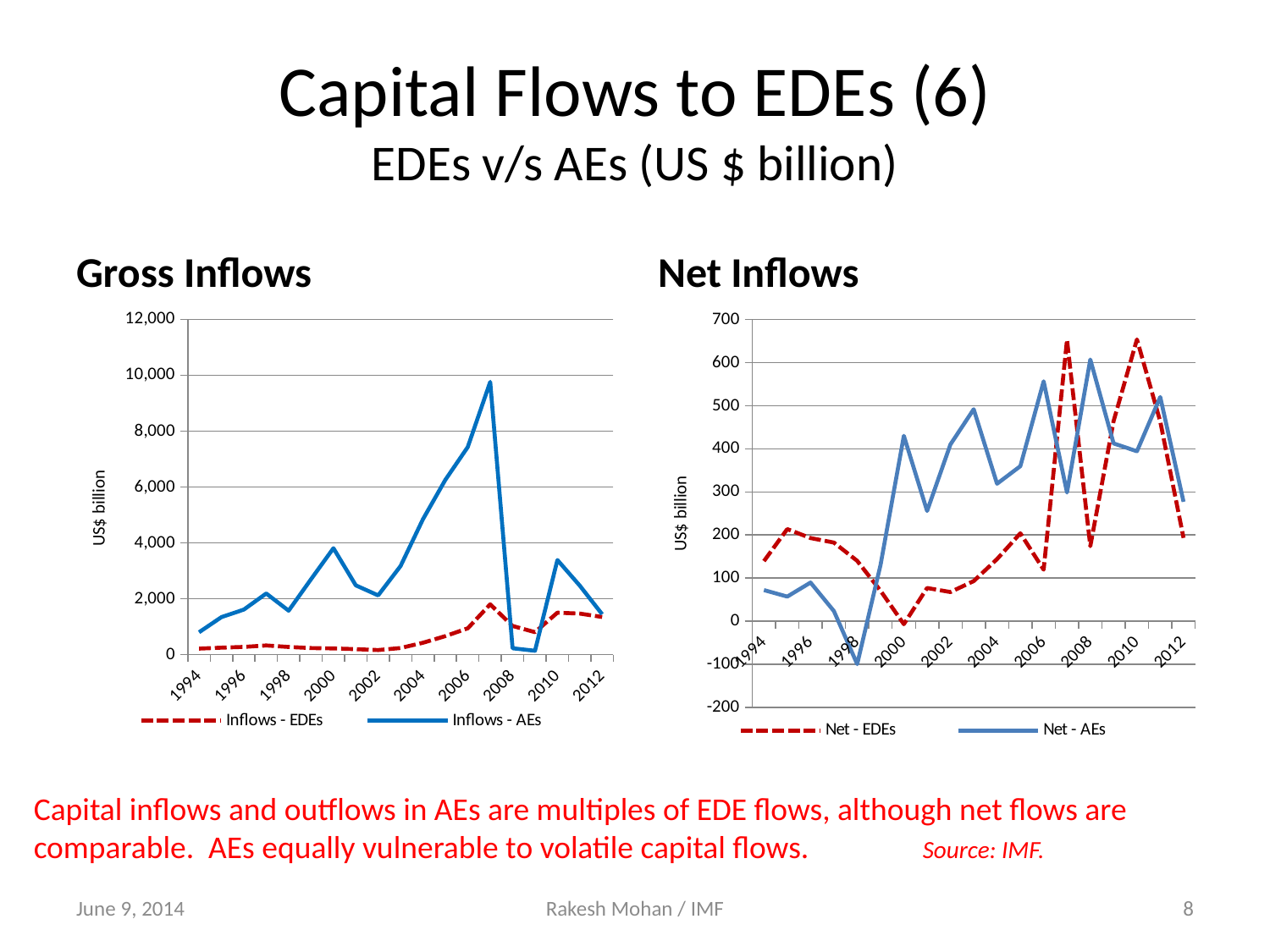
How many series does the legend of the Net Inflows chart list? 2 On the Gross Inflows chart, does the Inflows - AEs line rise or fall between 2002 and 2007? rise What are the two series named in the legend of the Gross Inflows chart? Inflows - EDEs and Inflows - AEs On the Gross Inflows chart, which series has the larger value in 2000, Inflows - EDEs or Inflows - AEs? Inflows - AEs What is the unit shown on the y axis of the Net Inflows chart? US$ billion What kind of chart is the Gross Inflows chart? line chart On the Gross Inflows chart, is the peak value of Inflows - AEs around 2007 greater or less than 8,000? greater On the Net Inflows chart, is the value of Net - EDEs in 2010 greater or less than 600? greater On the Net Inflows chart, which series has the larger value in 2007, Net - EDEs or Net - AEs? Net - EDEs On the Net Inflows chart, is the value of Net - AEs in 1998 greater or less than 0? less How many years are labelled on the x axis of the Net Inflows chart? 10